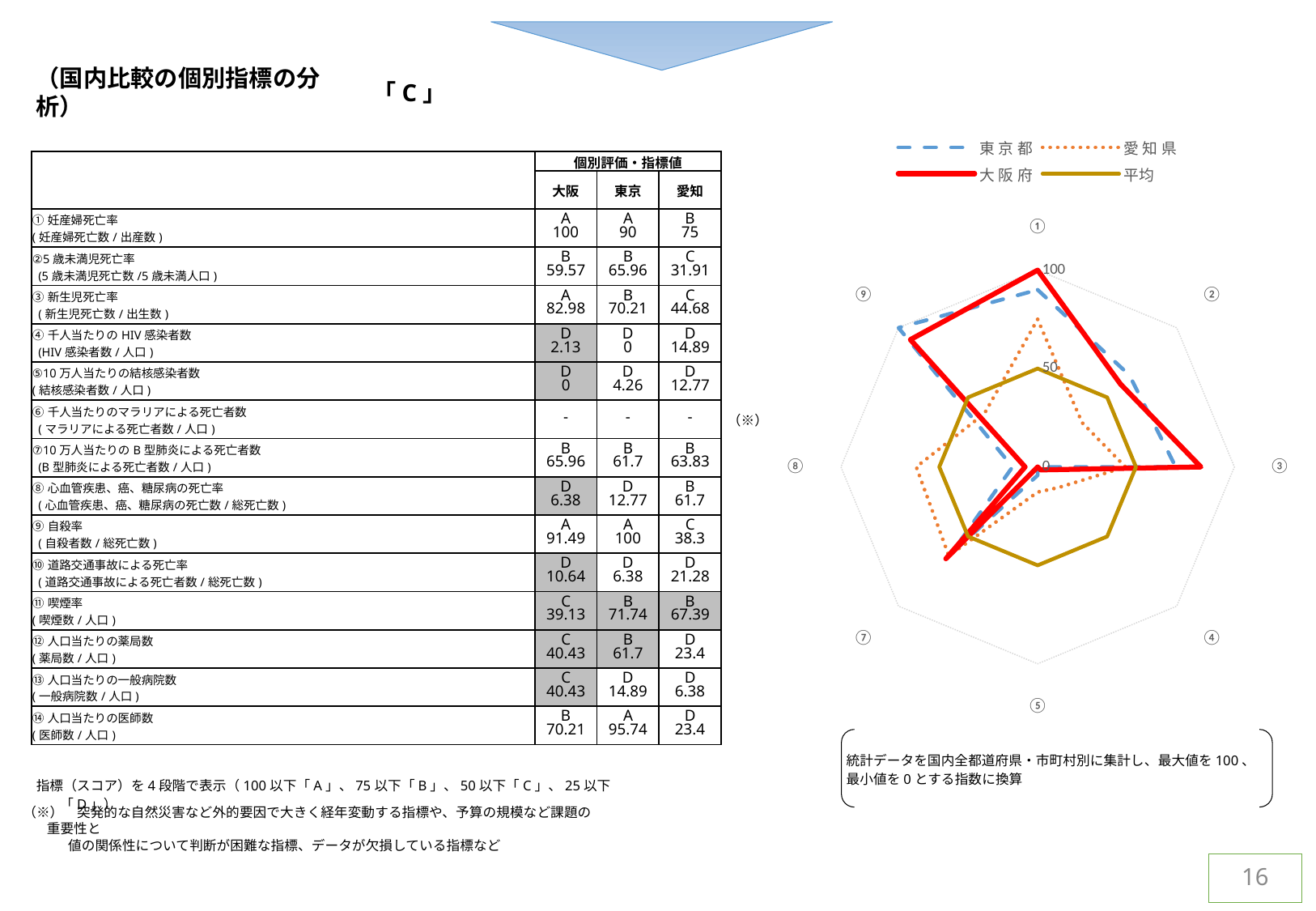
How many series does the legend of the radar chart list? 4 In the radar chart, is the value for 東京都 at axis ④ greater or less than 50? less What kind of chart is shown on the right side of the slide? radar chart In the radar chart, is the value for 東京都 at axis ⑨ greater or less than 50? greater In the radar chart, is the value for 大阪府 at axis ④ greater or less than 50? less Which series in the radar chart is drawn as a dotted orange line? 愛知県 Which series in the radar chart is drawn as a thick solid red line? 大阪府 How many axes (categories) does the radar chart have? 8